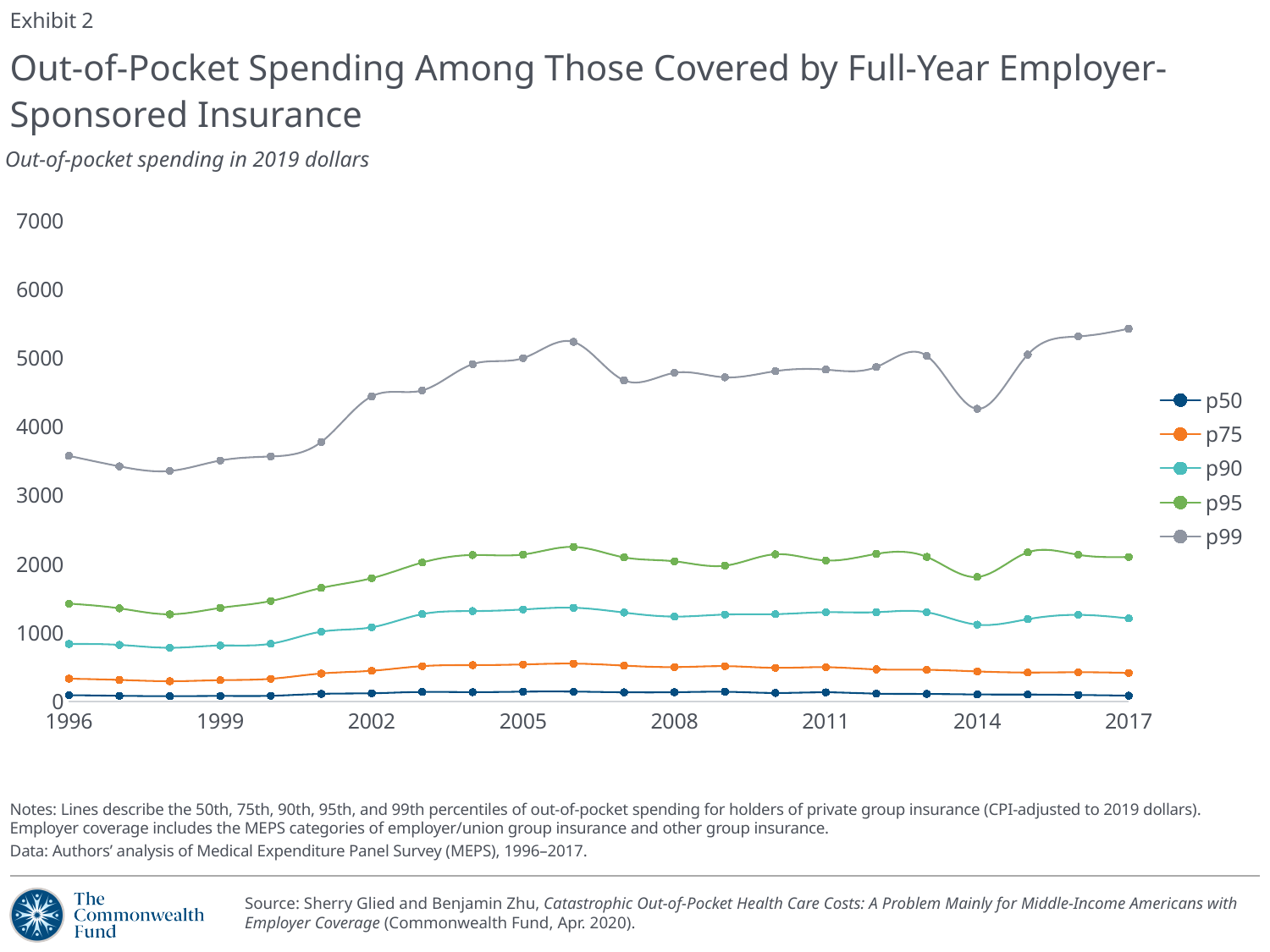
Does the p99 line overall rise or fall from 1996 to 2017? rise How many years (data points per line) are plotted on the x axis? 22 How many series does the legend list? 5 Is the value for p90 in 1996 greater or less than 1000? less Which series has the highest values throughout the chart? p99 What kind of chart is shown on the slide? Line chart Is the value for p75 in 2017 greater or less than 1000? less Is the value for p99 in 2017 greater or less than 5000? greater Which series has the lowest values throughout the chart? p50 Which is larger for p99: the value in 1996 or the value in 2017? 2017 What unit does the subtitle say the out-of-pocket spending is measured in? 2019 dollars